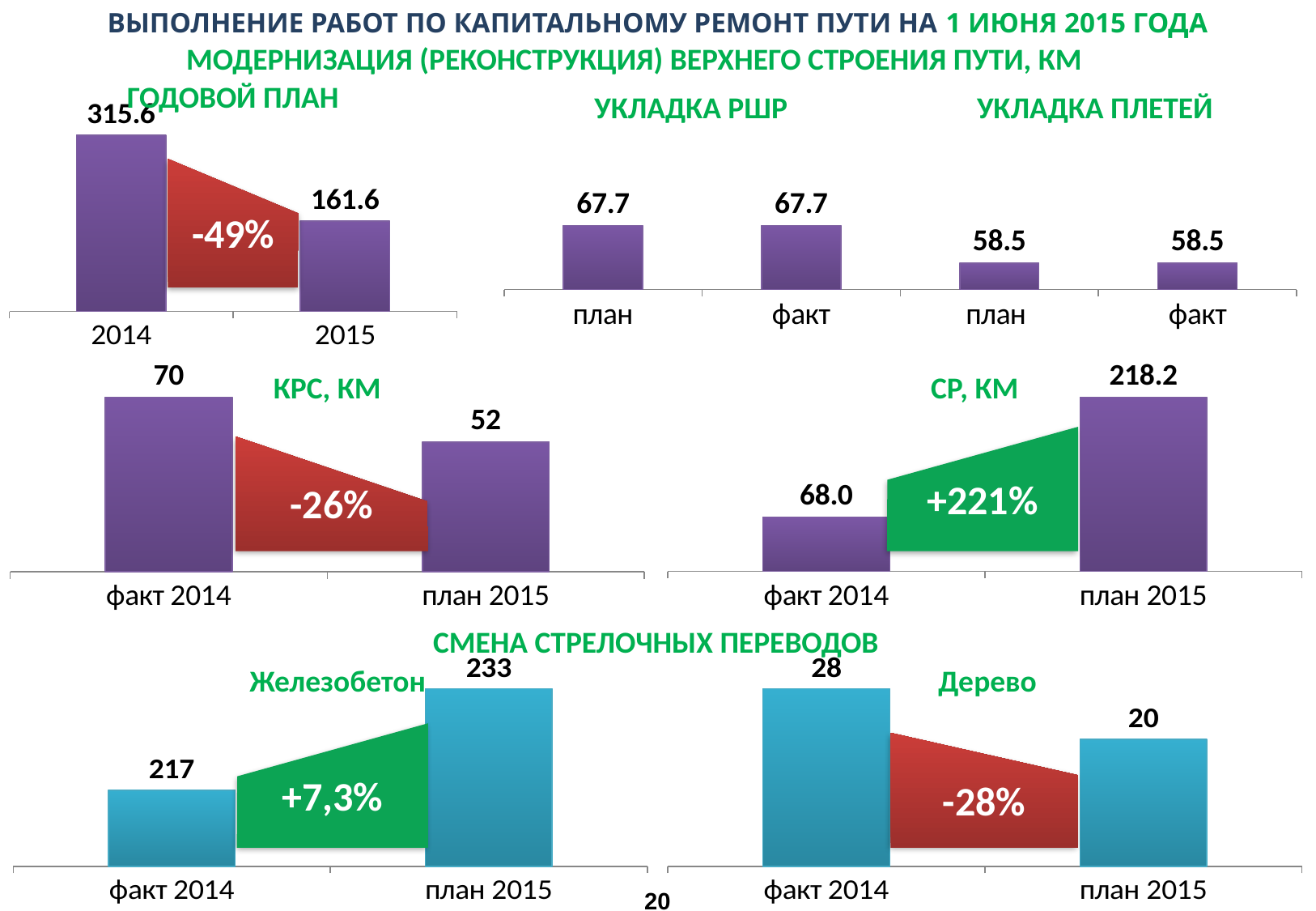
In the 'УКЛАДКА РШР' chart, what is the value for факт? 67.7 In the 'ГОДОВОЙ ПЛАН' chart, what is the value for 2015? 161.6 In the 'Дерево' chart under 'СМЕНА СТРЕЛОЧНЫХ ПЕРЕВОДОВ', which is larger, факт 2014 or план 2015? факт 2014 In the 'КРС, КМ' chart, what is the difference between факт 2014 and план 2015? 18 In the 'ГОДОВОЙ ПЛАН' chart, what is the value for 2014? 315.6 In the 'СР, КМ' chart, what is the value for план 2015? 218.2 In the 'КРС, КМ' chart, which category has the lower value, факт 2014 or план 2015? план 2015 In the 'УКЛАДКА ПЛЕТЕЙ' chart, what is the value for план? 58.5 In the 'СР, КМ' chart, do the values rise or fall from факт 2014 to план 2015? rise What kind of chart is the 'Дерево' chart under 'СМЕНА СТРЕЛОЧНЫХ ПЕРЕВОДОВ'? bar chart In the 'ГОДОВОЙ ПЛАН' chart, what is the difference between the 2014 and 2015 values? 154.0 In the 'Железобетон' chart under 'СМЕНА СТРЕЛОЧНЫХ ПЕРЕВОДОВ', what is the value for факт 2014? 217